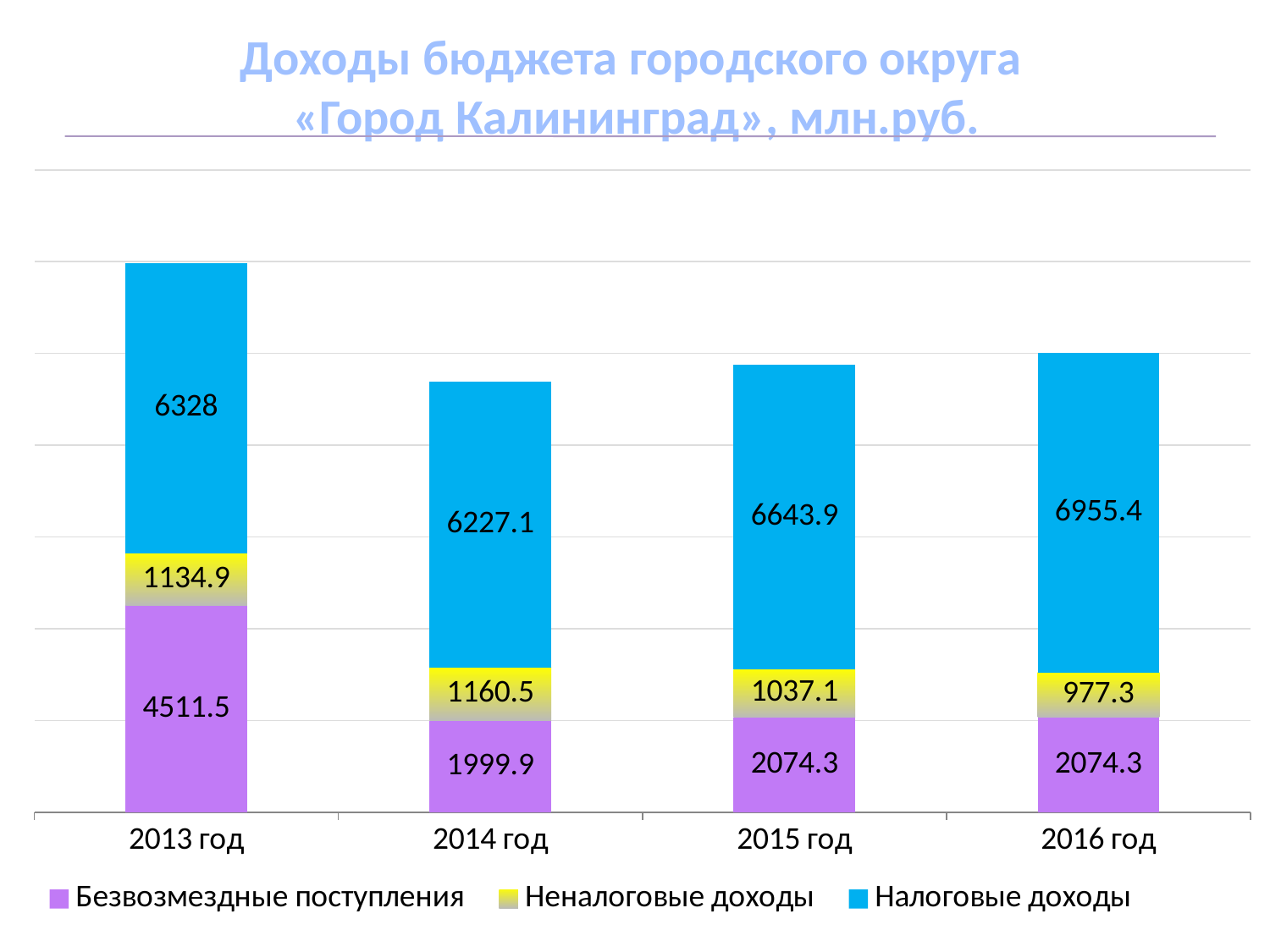
In which year is Неналоговые доходы lowest? 2016 год In which year is Налоговые доходы highest? 2016 год How many series does the legend list? 3 Do the Налоговые доходы values rise or fall from 2014 год to 2016 год? Rise How many years are shown on the x axis? 4 What is the value of Налоговые доходы for 2013 год? 6328 What is the value of Неналоговые доходы for 2016 год? 977.3 What is the value of Безвозмездные поступления for 2014 год? 1999.9 What type of chart is shown on the slide? Stacked bar chart What is the difference between Налоговые доходы in 2016 год and 2015 год? 311.5 Which is larger: Безвозмездные поступления in 2013 год or in 2015 год? 2013 год What is the total of the stacked bar for 2014 год? 9387.5